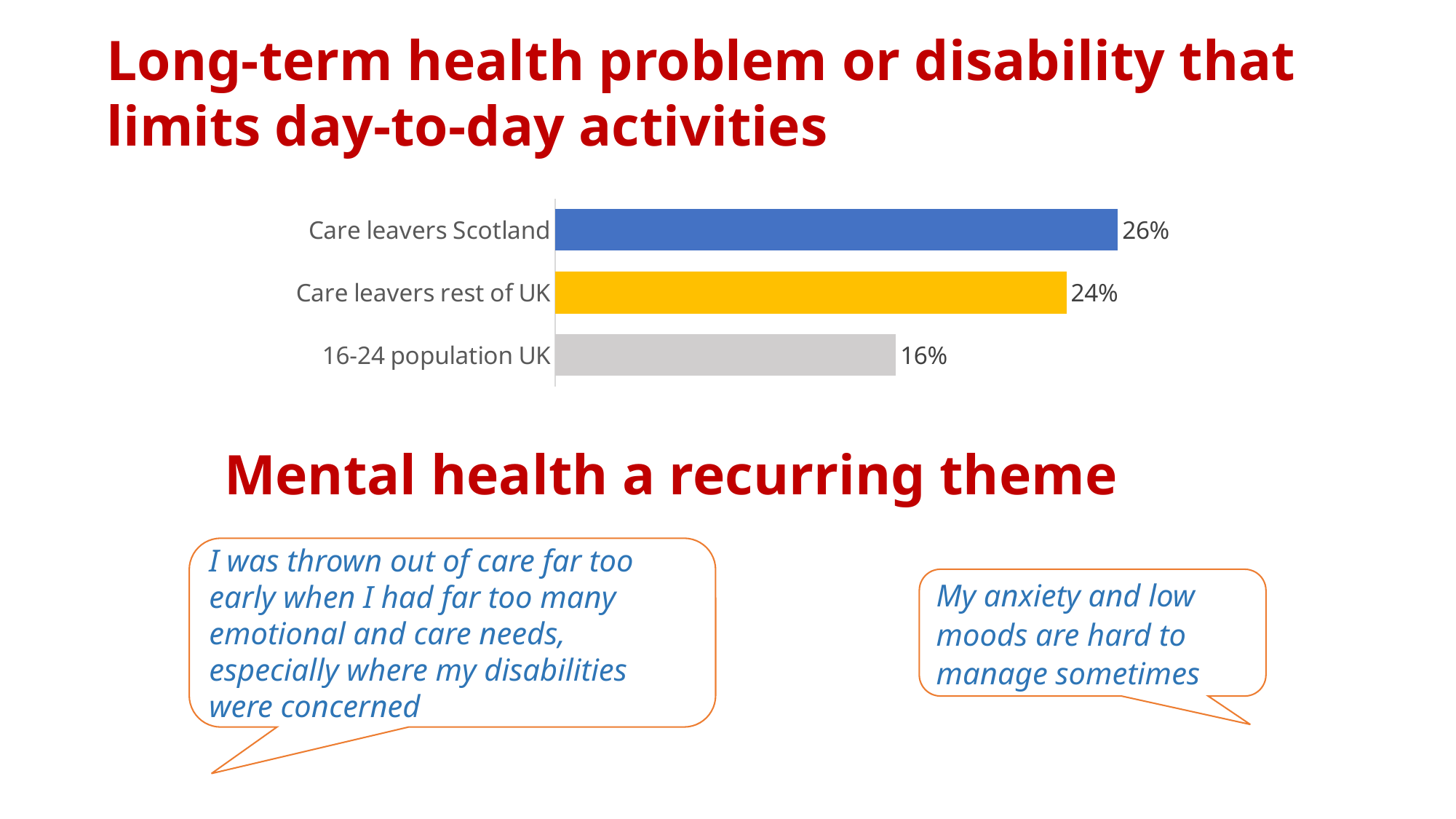
What is the value for Care leavers rest of UK? 24% Which category has the highest value? Care leavers Scotland What is the difference between the values for Care leavers Scotland and 16-24 population UK? 10% Which category has the lowest value? 16-24 population UK What colour is the bar for Care leavers rest of UK? Yellow How many categories are shown in the chart? 3 What is the value for Care leavers Scotland? 26% What colour is the bar for Care leavers Scotland? Blue What is the difference between the values for Care leavers Scotland and Care leavers rest of UK? 2% What is the value for 16-24 population UK? 16% Which is larger, the value for Care leavers rest of UK or the value for 16-24 population UK? Care leavers rest of UK What kind of chart is shown on the slide? Bar chart